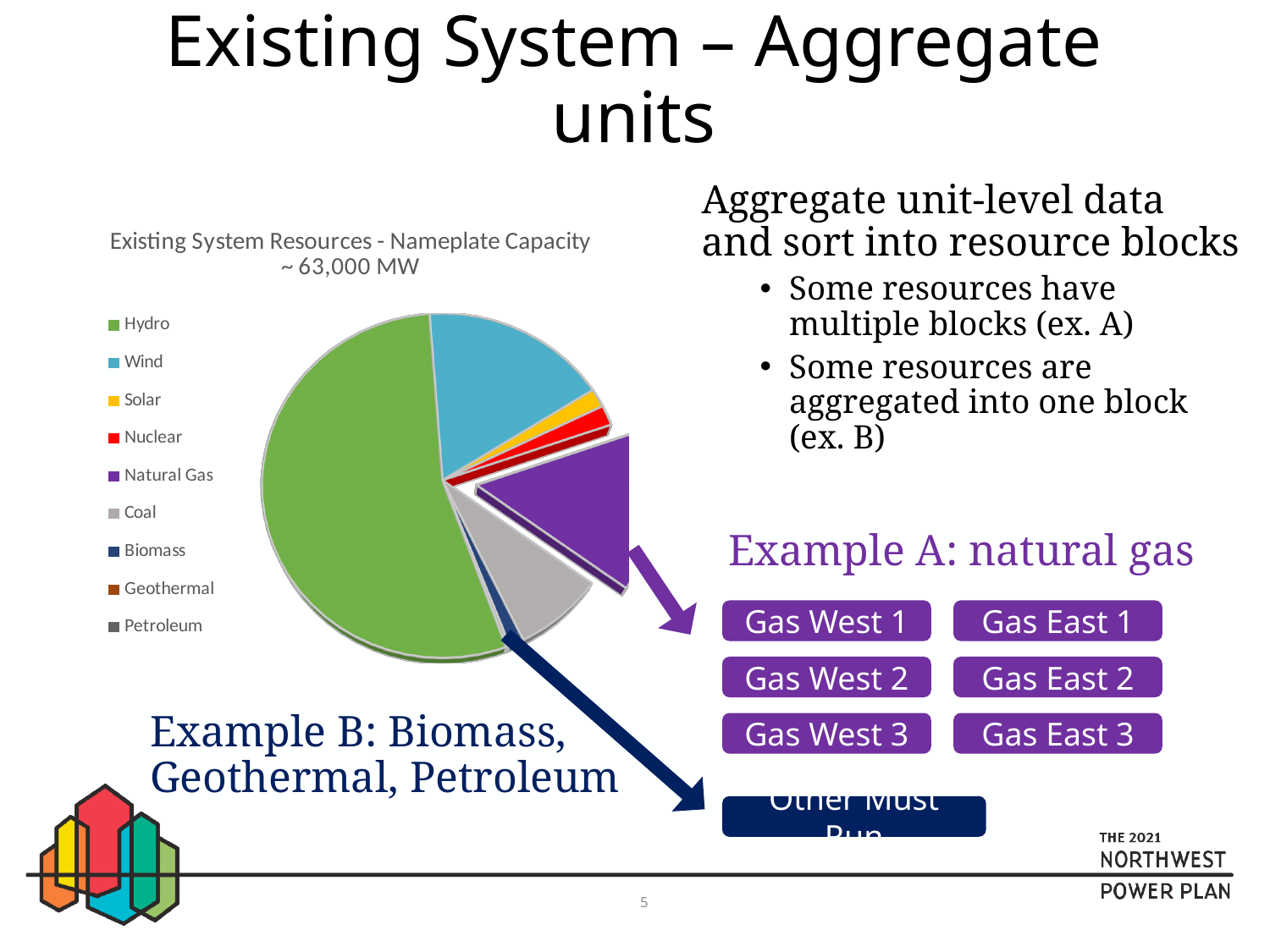
What is the title of the pie chart? Existing System Resources - Nameplate Capacity ~ 63,000 MW Which slice is larger in the pie chart, Hydro or Wind? Hydro Which slice is larger in the pie chart, Natural Gas or Solar? Natural Gas What kind of chart is shown on the slide? pie chart How many resource categories does the pie chart's legend list? 9 Which resource's slice is pulled out (exploded) from the pie chart? Natural Gas Which resource has the largest slice in the pie chart? Hydro Which slice is larger in the pie chart, Wind or Coal? Wind